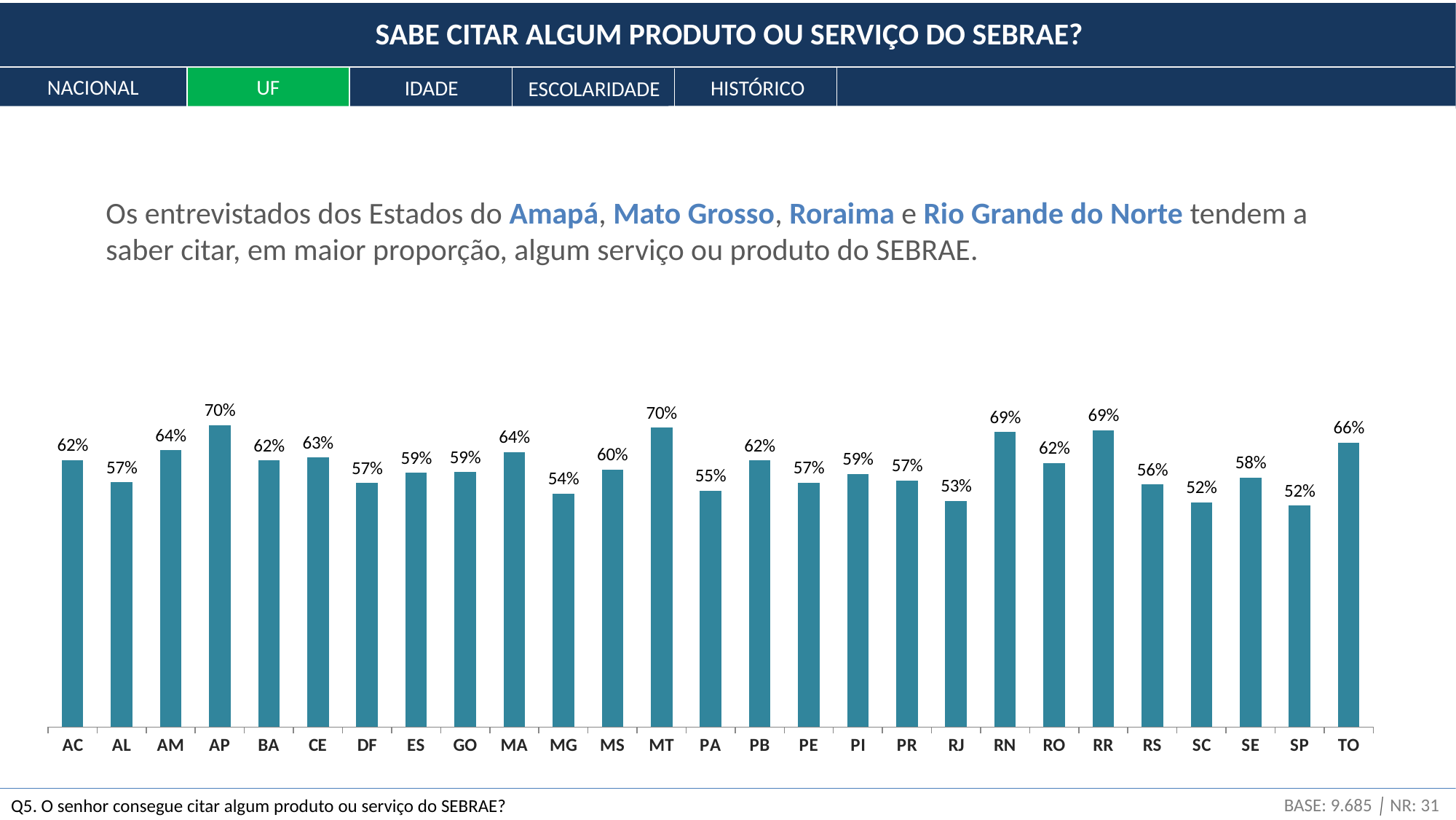
How many states (UF) are shown on the chart? 27 What is the difference between the values for RN and RS? 13% Which two states share the lowest value on the chart? SC and SP What is the value for RJ? 53% Which two states share the highest value on the chart? AP and MT Which has a larger value, RR or RO? RR What is the difference between the values for TO and SP? 14% Which has a larger value, MA or PA? MA What is the value for TO? 66% What kind of chart is shown on the slide? Bar chart What is the value for AP? 70% What is the value for MG? 54%